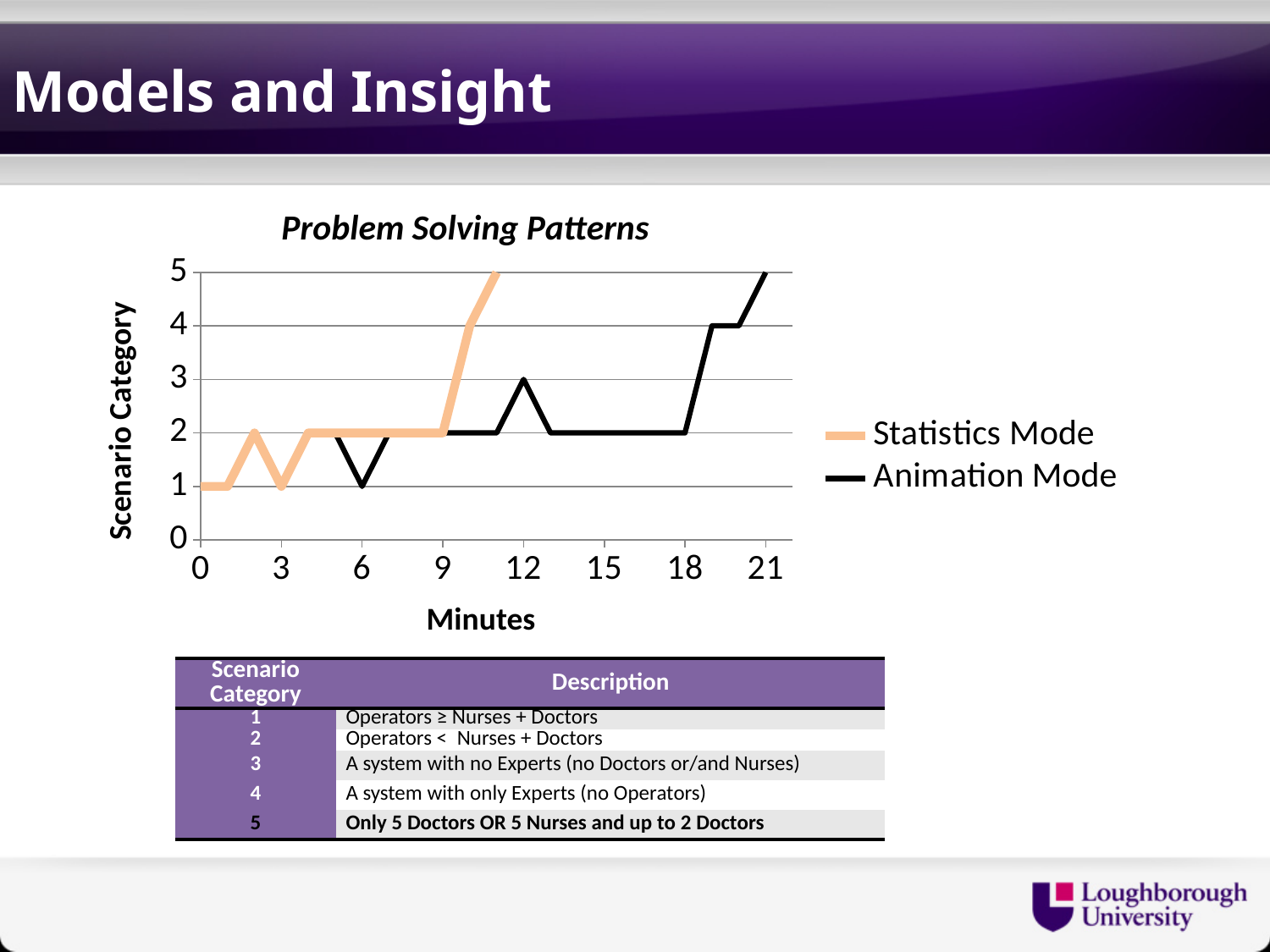
At 6 minutes, which series has the higher Scenario Category, Statistics Mode or Animation Mode? Statistics Mode What is the Scenario Category for Animation Mode at 21 minutes? 5 What is the Scenario Category for Statistics Mode at 9 minutes? 2 What is the Scenario Category for Statistics Mode at 3 minutes? 1 What is the label of the y axis? Scenario Category What kind of chart is shown on the slide? line chart What is the Scenario Category for Animation Mode at 6 minutes? 1 What is the highest Scenario Category reached by the Animation Mode line? 5 What is the Scenario Category for Animation Mode at 12 minutes? 3 What is the title of the chart? Problem Solving Patterns How many series does the legend list? 2 Overall, does the Animation Mode line rise or fall as minutes increase? rise